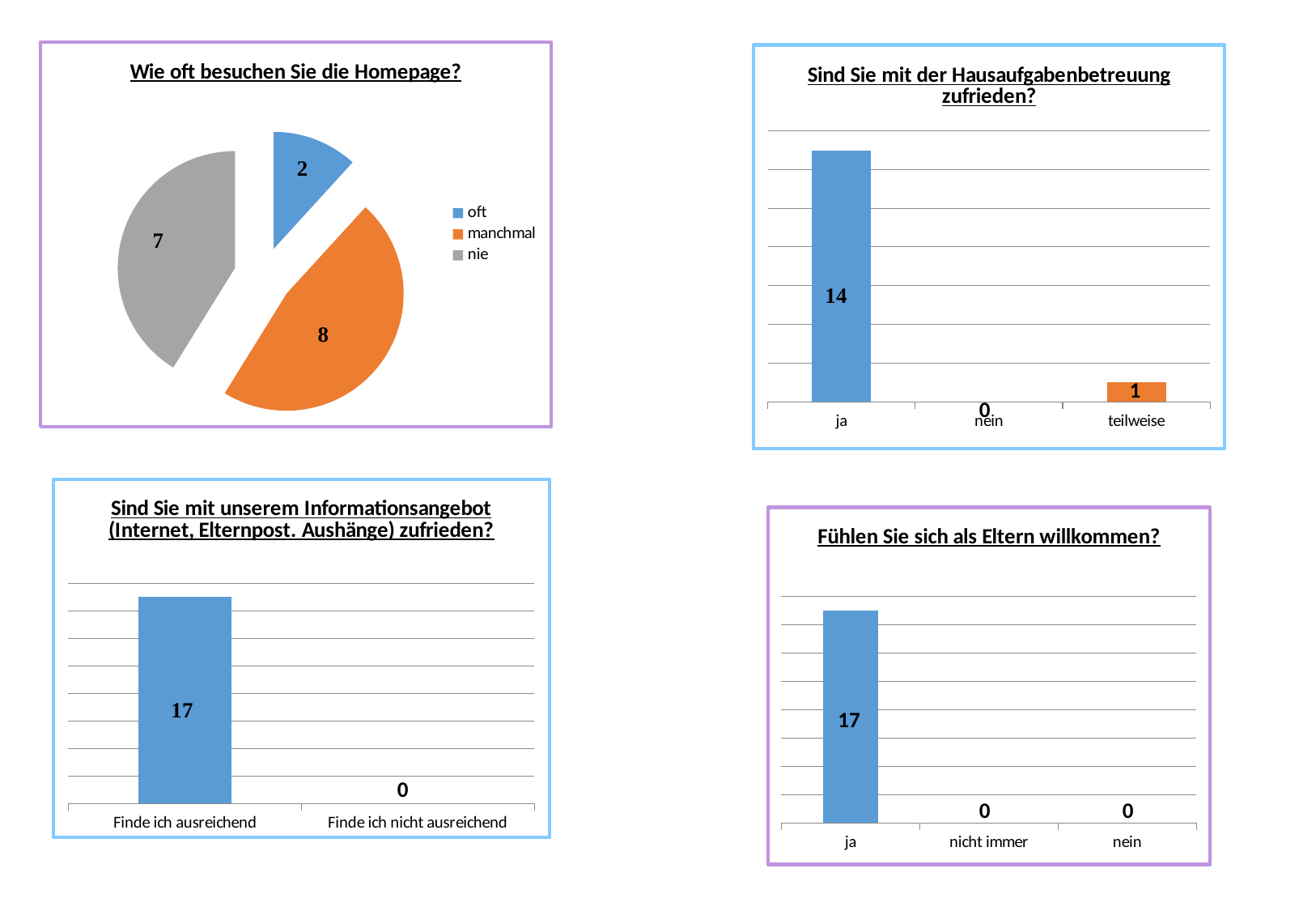
How many entries does the legend of 'Wie oft besuchen Sie die Homepage?' list? 3 In the chart 'Sind Sie mit unserem Informationsangebot (Internet, Elternpost. Aushänge) zufrieden?', what is the difference between 'Finde ich ausreichend' and 'Finde ich nicht ausreichend'? 17 In the chart 'Sind Sie mit der Hausaufgabenbetreuung zufrieden?', what is the value for 'teilweise'? 1 In the chart 'Sind Sie mit unserem Informationsangebot (Internet, Elternpost. Aushänge) zufrieden?', what is the value for 'Finde ich ausreichend'? 17 In the chart 'Sind Sie mit der Hausaufgabenbetreuung zufrieden?', what is the value for 'ja'? 14 What kind of chart is 'Wie oft besuchen Sie die Homepage?'? pie chart In the chart 'Sind Sie mit der Hausaufgabenbetreuung zufrieden?', how many categories are shown on the x axis? 3 In the chart 'Wie oft besuchen Sie die Homepage?', what is the difference between 'manchmal' and 'nie'? 1 In the chart 'Fühlen Sie sich als Eltern willkommen?', which category has the highest value? ja What kind of chart is 'Fühlen Sie sich als Eltern willkommen?'? bar chart In the chart 'Wie oft besuchen Sie die Homepage?', what is the value for 'manchmal'? 8 In the chart 'Wie oft besuchen Sie die Homepage?', which category has the smallest slice? oft